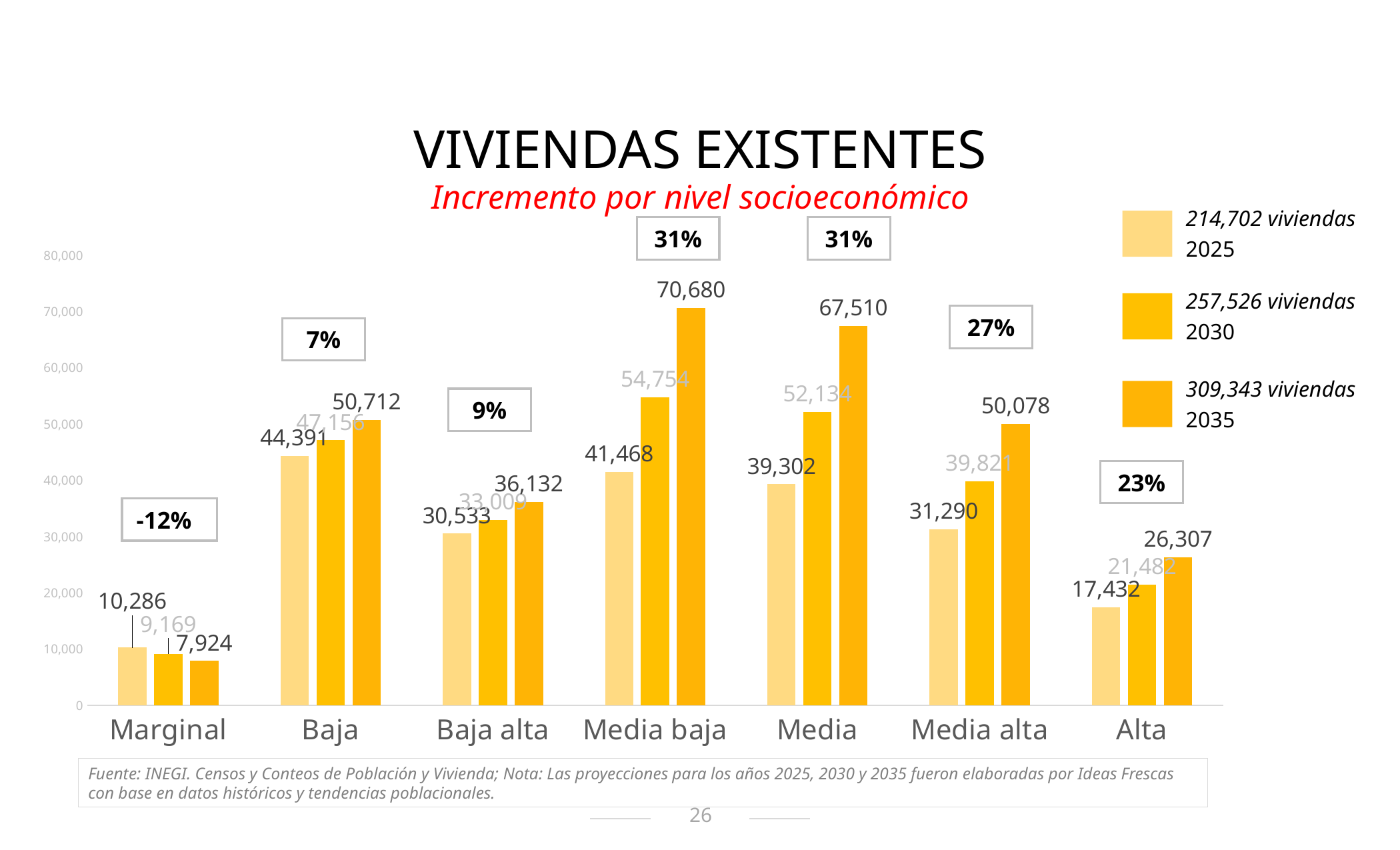
How many series does the legend list? 3 Do the values for Marginal rise or fall from 2025 to 2035? Fall Which socioeconomic level has the lowest 2030 value? Marginal What is the 2025 value for Marginal? 10,286 What kind of chart is shown on the slide? Bar chart How many socioeconomic levels are shown on the x axis? 7 What is the difference between the 2035 and 2025 values for Media baja? 29,212 Which socioeconomic level has the highest 2035 value? Media baja What is the difference between the 2035 and 2030 values for Alta? 4,825 What is the 2030 value for Alta? 21,482 What is the 2035 value for Media baja? 70,680 Which is larger in 2025: Baja or Media baja? Baja